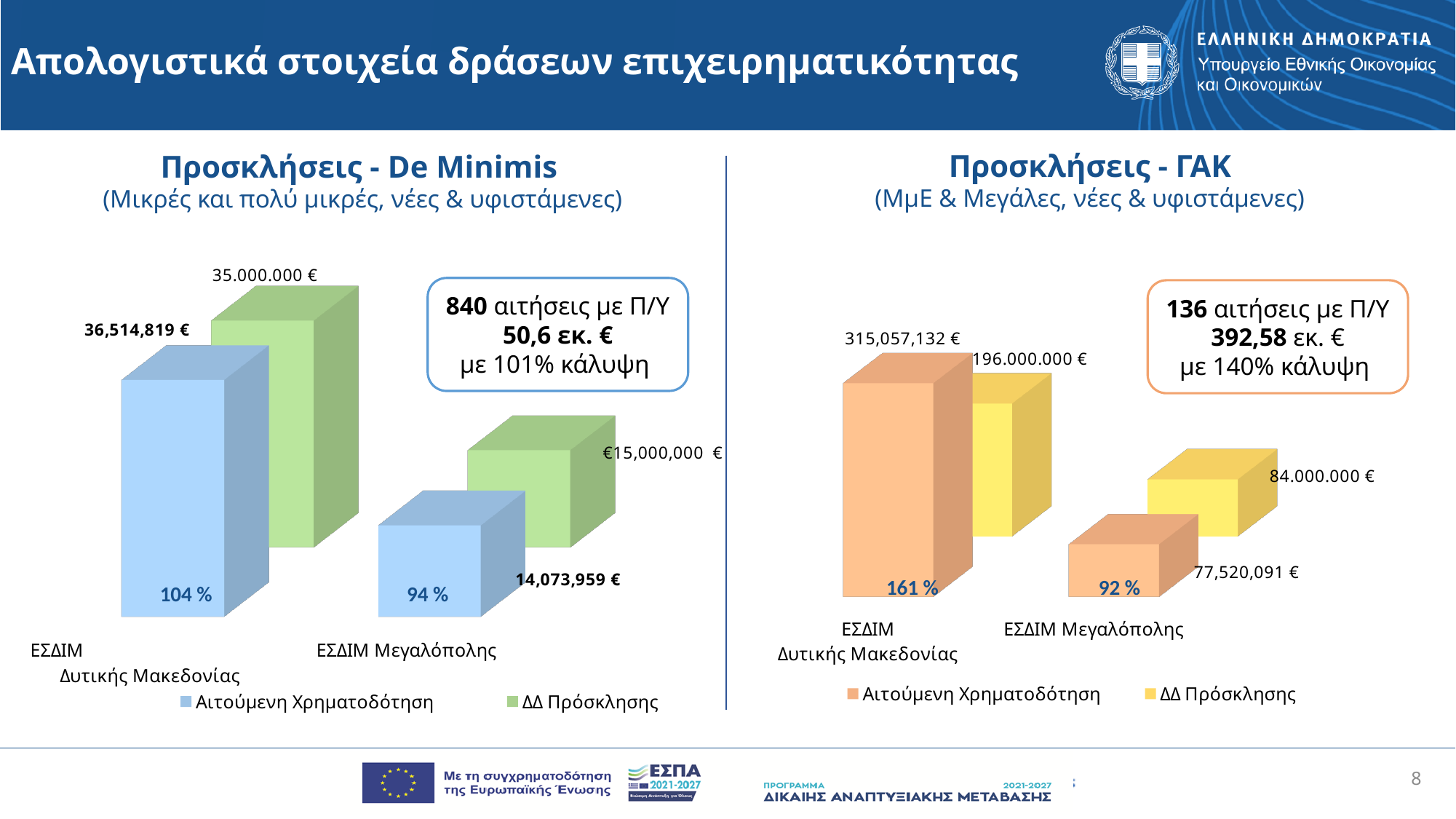
In the 'Προσκλήσεις - ΓΑΚ' chart, what is the difference between Αιτούμενη Χρηματοδότηση and ΔΔ Πρόσκλησης for ΕΣΔΙΜ Δυτικής Μακεδονίας? 119,057,132 € What type of chart is the 'Προσκλήσεις - De Minimis' chart? Bar chart How many categories are shown in the 'Προσκλήσεις - ΓΑΚ' chart? 2 In the 'Προσκλήσεις - ΓΑΚ' chart, what is the value of Αιτούμενη Χρηματοδότηση for ΕΣΔΙΜ Δυτικής Μακεδονίας? 315,057,132 € In the 'Προσκλήσεις - De Minimis' chart, which category has the lowest ΔΔ Πρόσκλησης? ΕΣΔΙΜ Μεγαλόπολης In the 'Προσκλήσεις - ΓΑΚ' chart, which category has the highest Αιτούμενη Χρηματοδότηση? ΕΣΔΙΜ Δυτικής Μακεδονίας In the 'Προσκλήσεις - ΓΑΚ' chart, what is the value of ΔΔ Πρόσκλησης for ΕΣΔΙΜ Μεγαλόπολης? 84.000.000 € How many series does the legend of the 'Προσκλήσεις - De Minimis' chart list? 2 In the 'Προσκλήσεις - ΓΑΚ' chart, for ΕΣΔΙΜ Μεγαλόπολης, which is larger: Αιτούμενη Χρηματοδότηση or ΔΔ Πρόσκλησης? ΔΔ Πρόσκλησης In the 'Προσκλήσεις - De Minimis' chart, what is the value of ΔΔ Πρόσκλησης for ΕΣΔΙΜ Μεγαλόπολης? €15,000,000 In the 'Προσκλήσεις - De Minimis' chart, what is the value of Αιτούμενη Χρηματοδότηση for ΕΣΔΙΜ Δυτικής Μακεδονίας? 36,514,819 € In the 'Προσκλήσεις - De Minimis' chart, for ΕΣΔΙΜ Δυτικής Μακεδονίας, which is larger: Αιτούμενη Χρηματοδότηση or ΔΔ Πρόσκλησης? Αιτούμενη Χρηματοδότηση